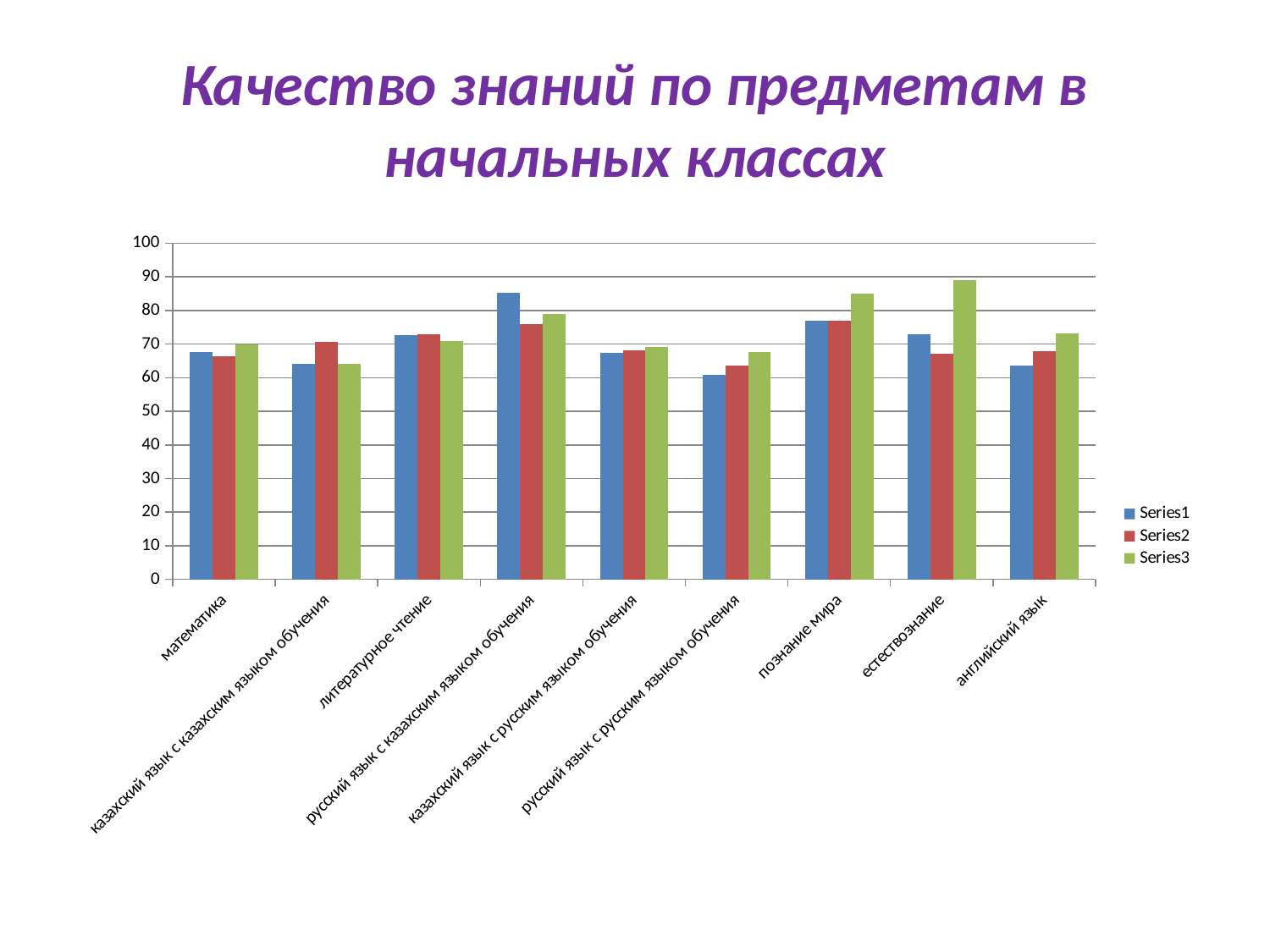
What kind of chart is shown on the slide? bar chart Is the Series3 value for естествознание greater or less than 80? greater For английский язык, which is larger: the Series1 value or the Series3 value? Series3 Is the Series2 value for естествознание greater or less than 70? less How many series does the legend list? 3 How many subject categories are shown on the x axis? 9 Which subject has the highest Series3 value? естествознание Which subject has the highest Series1 value? русский язык с казахским языком обучения Is the Series1 value for русский язык с русским языком обучения greater or less than 70? less What is the title of the chart on the slide? Качество знаний по предметам в начальных классах Which colour represents Series2 in the legend? red Which subject has the lowest Series1 value? русский язык с русским языком обучения